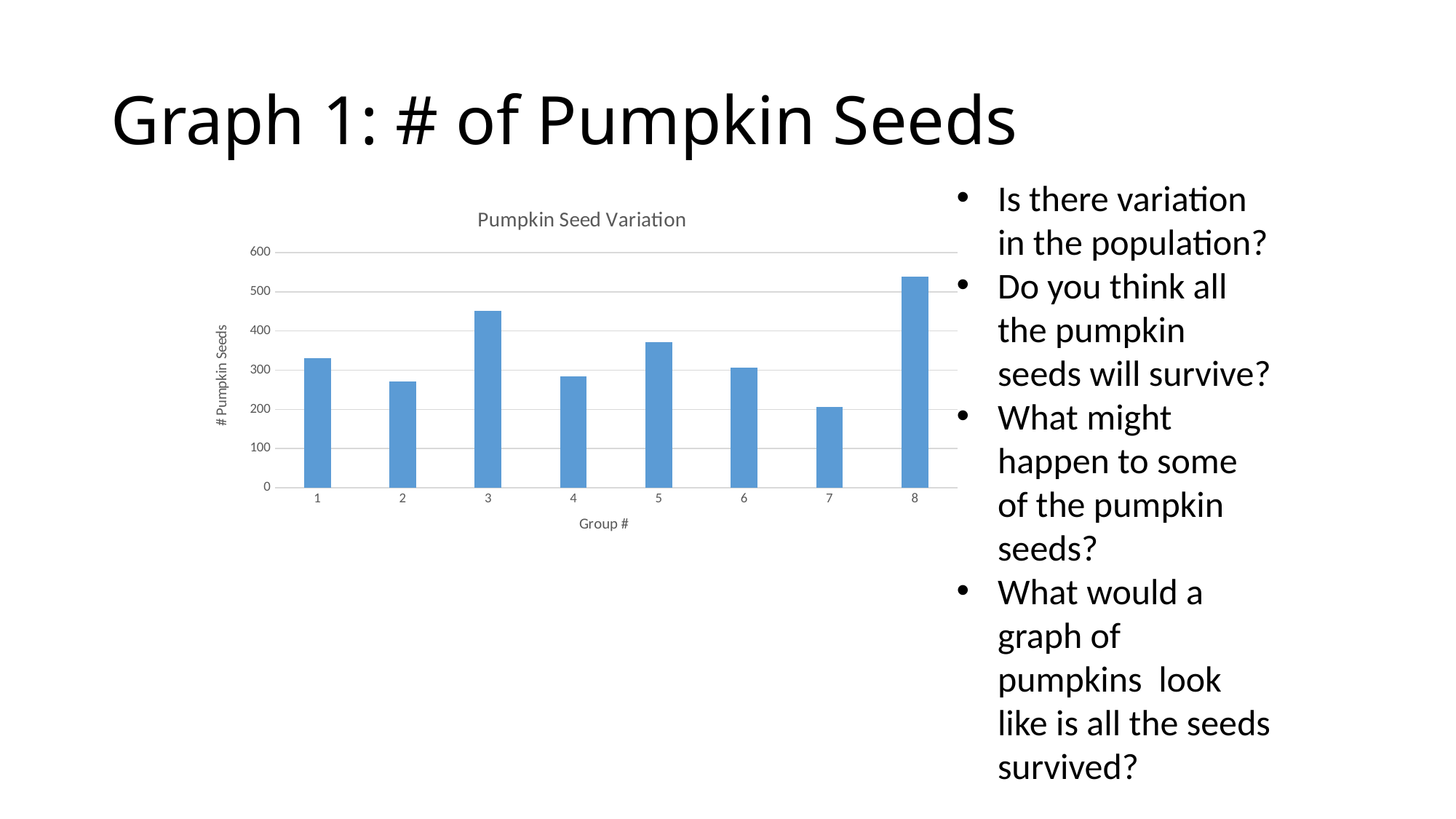
What kind of chart is shown on the slide? bar chart How many groups are plotted on the x axis of the chart? 8 Is the value for group 3 greater or less than 400? greater What is the label on the y axis of the chart? # Pumpkin Seeds Which group has more pumpkin seeds, group 1 or group 2? 1 Is the value for group 8 greater or less than 500? greater Is the value for group 2 greater or less than 300? less What is the title of the chart? Pumpkin Seed Variation Which group has more pumpkin seeds, group 3 or group 5? 3 Which group has the highest number of pumpkin seeds? 8 Which group has the lowest number of pumpkin seeds? 7